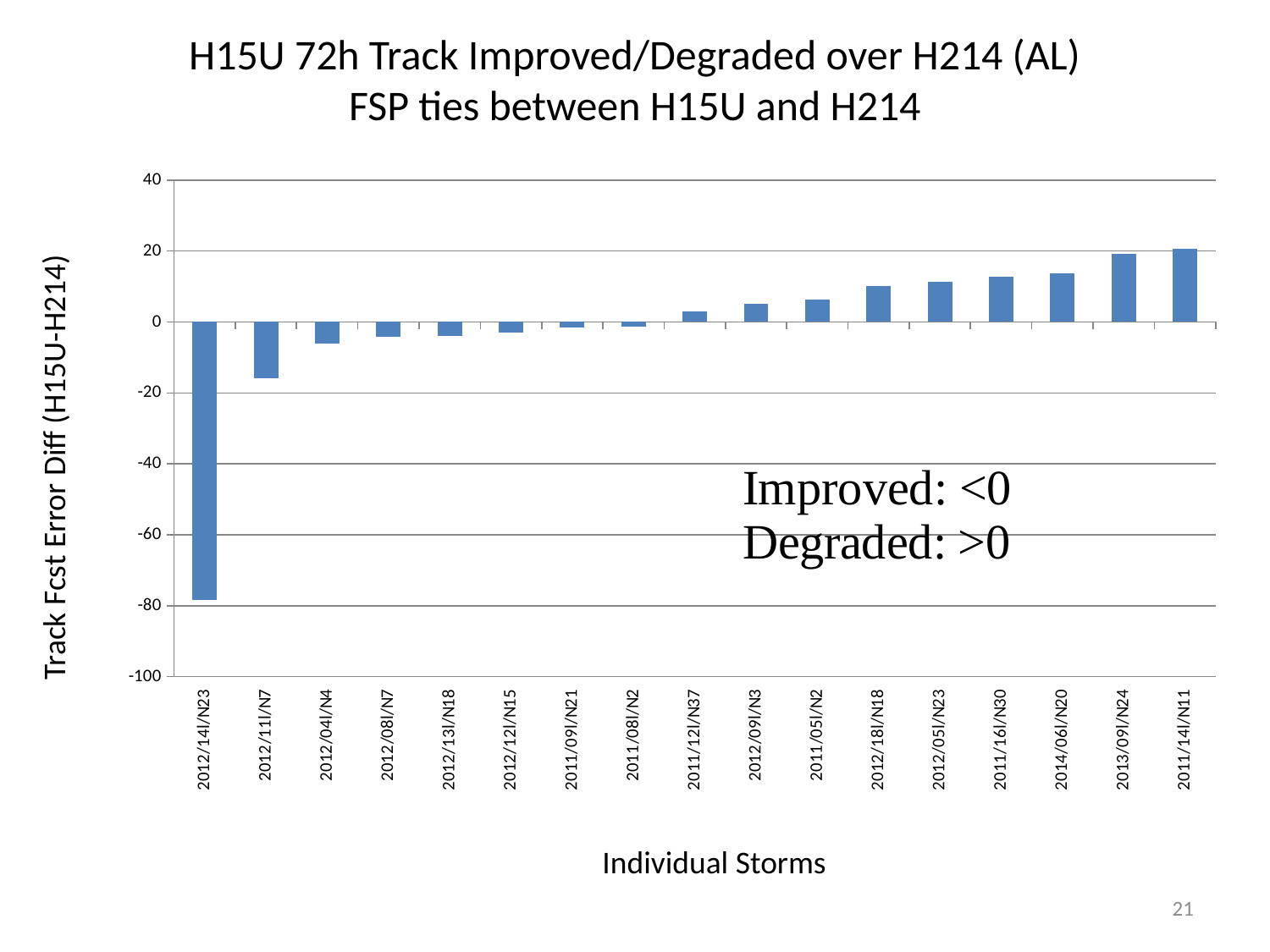
Which storm has the highest track forecast error difference? 2011/14I/N11 What kind of chart is shown on the slide? bar chart How many individual storms (categories) are plotted on the x axis? 17 Do the bar values rise or fall moving left to right along the x axis? rise Is the value for 2012/18I/N18 greater or less than 0? greater Is the value for 2012/05I/N23 greater or less than 20? less Is the value for 2012/14I/N23 greater or less than -60? less Which has the larger value, 2014/06I/N20 or 2012/18I/N18? 2014/06I/N20 What is the label of the x axis? Individual Storms Which has the larger value, 2012/11I/N7 or 2012/04I/N4? 2012/04I/N4 Which storm has the lowest track forecast error difference? 2012/14I/N23